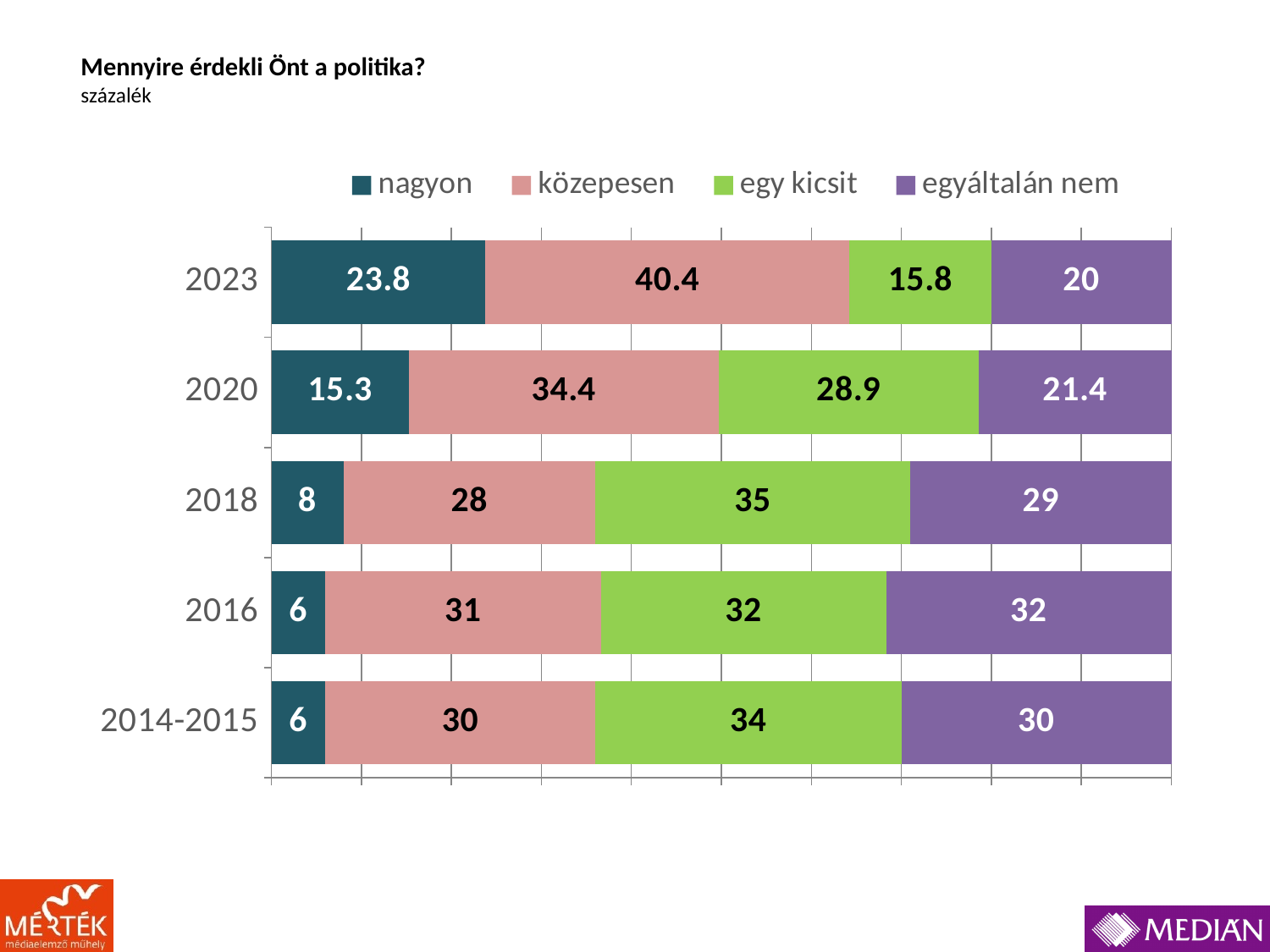
In which year is the "egy kicsit" value lowest? 2023 What is the total of the stacked bar for 2018? 100 How many year categories are shown on the chart? 5 How many series does the legend list? 4 What is the difference between the "közepesen" values for 2023 and 2020? 6 What is the value for "egyáltalán nem" in 2018? 29 Which is larger: the "egyáltalán nem" value in 2016 or in 2020? 2016 What is the value for "egy kicsit" in 2020? 28.9 What is the value for "közepesen" in 2014-2015? 30 What is the value for "nagyon" in 2023? 23.8 In which year is the "nagyon" value highest? 2023 What kind of chart is shown on the slide? Stacked bar chart